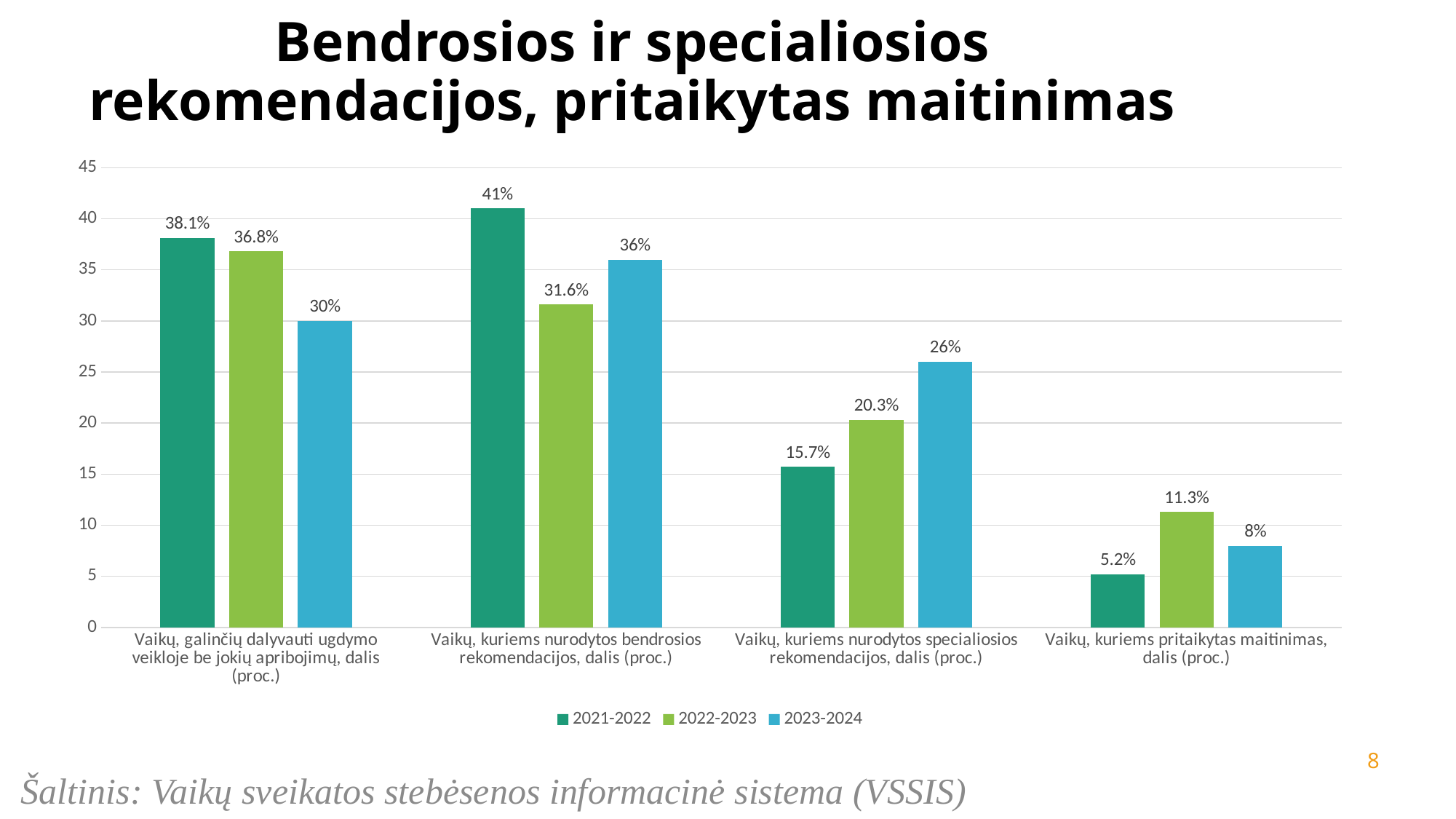
What kind of chart is shown on the slide? Bar chart What is the value for 2023-2024 in the category 'Vaikų, kuriems pritaikytas maitinimas, dalis (proc.)'? 8% Which series has the highest value in the category 'Vaikų, galinčių dalyvauti ugdymo veikloje be jokių apribojimų, dalis (proc.)'? 2021-2022 How many series does the legend list? 3 What is the value for 2021-2022 in the category 'Vaikų, kuriems nurodytos bendrosios rekomendacijos, dalis (proc.)'? 41% Which is larger: the 2022-2023 value or the 2023-2024 value in the category 'Vaikų, kuriems nurodytos bendrosios rekomendacijos, dalis (proc.)'? 2023-2024 What is the difference between the 2021-2022 and 2023-2024 values in the category 'Vaikų, galinčių dalyvauti ugdymo veikloje be jokių apribojimų, dalis (proc.)'? 8.1% What is the value for 2022-2023 in the category 'Vaikų, kuriems nurodytos specialiosios rekomendacijos, dalis (proc.)'? 20.3% How many categories are shown on the x axis? 4 Which series has the lowest value in the category 'Vaikų, kuriems pritaikytas maitinimas, dalis (proc.)'? 2021-2022 Which series is shown in blue in the legend? 2023-2024